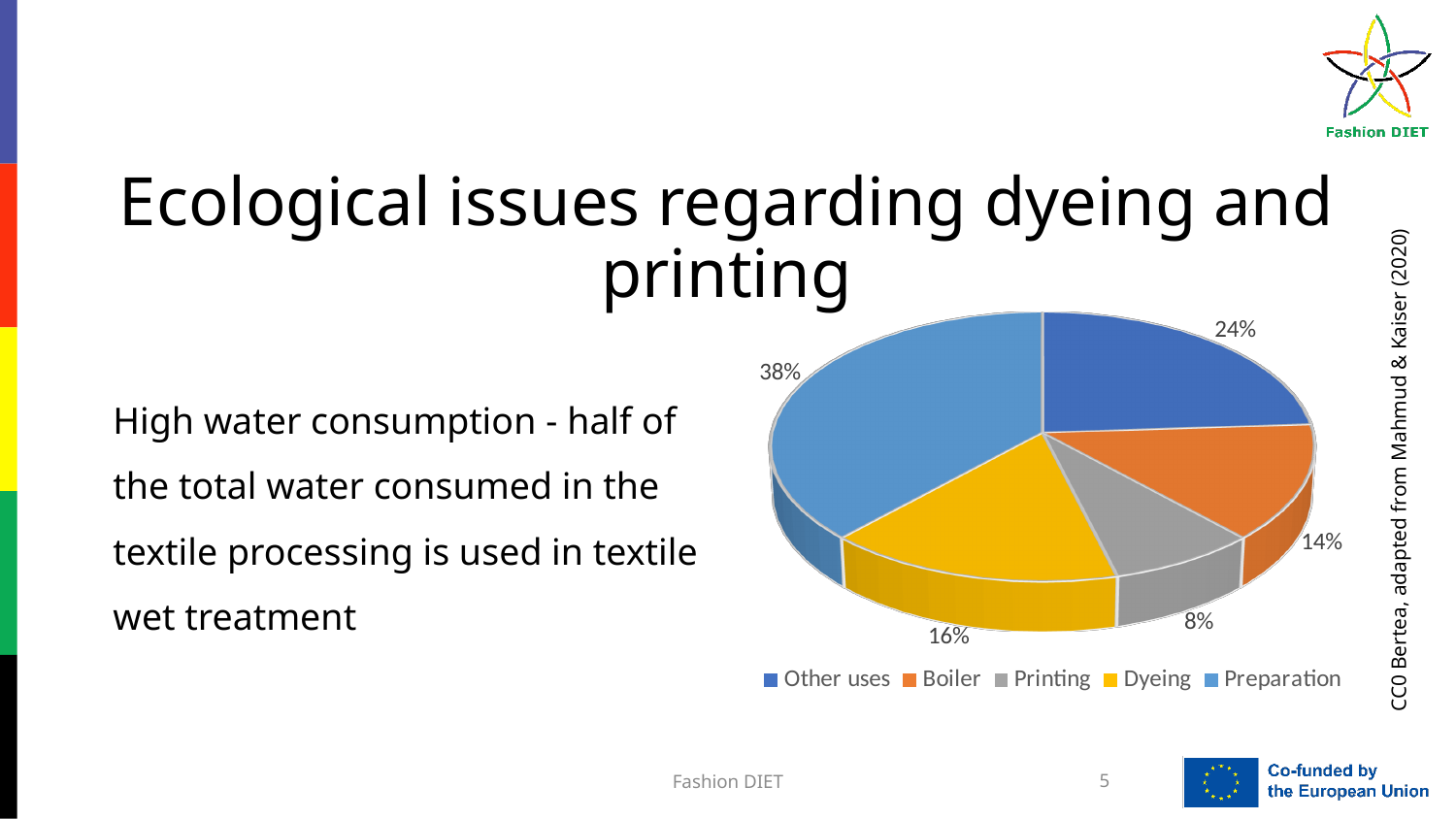
What kind of chart is shown on the slide? pie chart Which category has the largest slice of the pie? Preparation Which category has the smallest slice of the pie? Printing What is the value shown for Boiler? 14% What share of the pie does Preparation account for? 38% How many categories does the pie chart show? 5 Which is larger, the Dyeing slice or the Boiler slice? Dyeing What is the value shown for Other uses? 24% Which colour represents Dyeing in the legend? yellow What is the value shown for Printing? 8% What is the difference between the Preparation share and the Other uses share? 14% What is the value shown for Dyeing? 16%